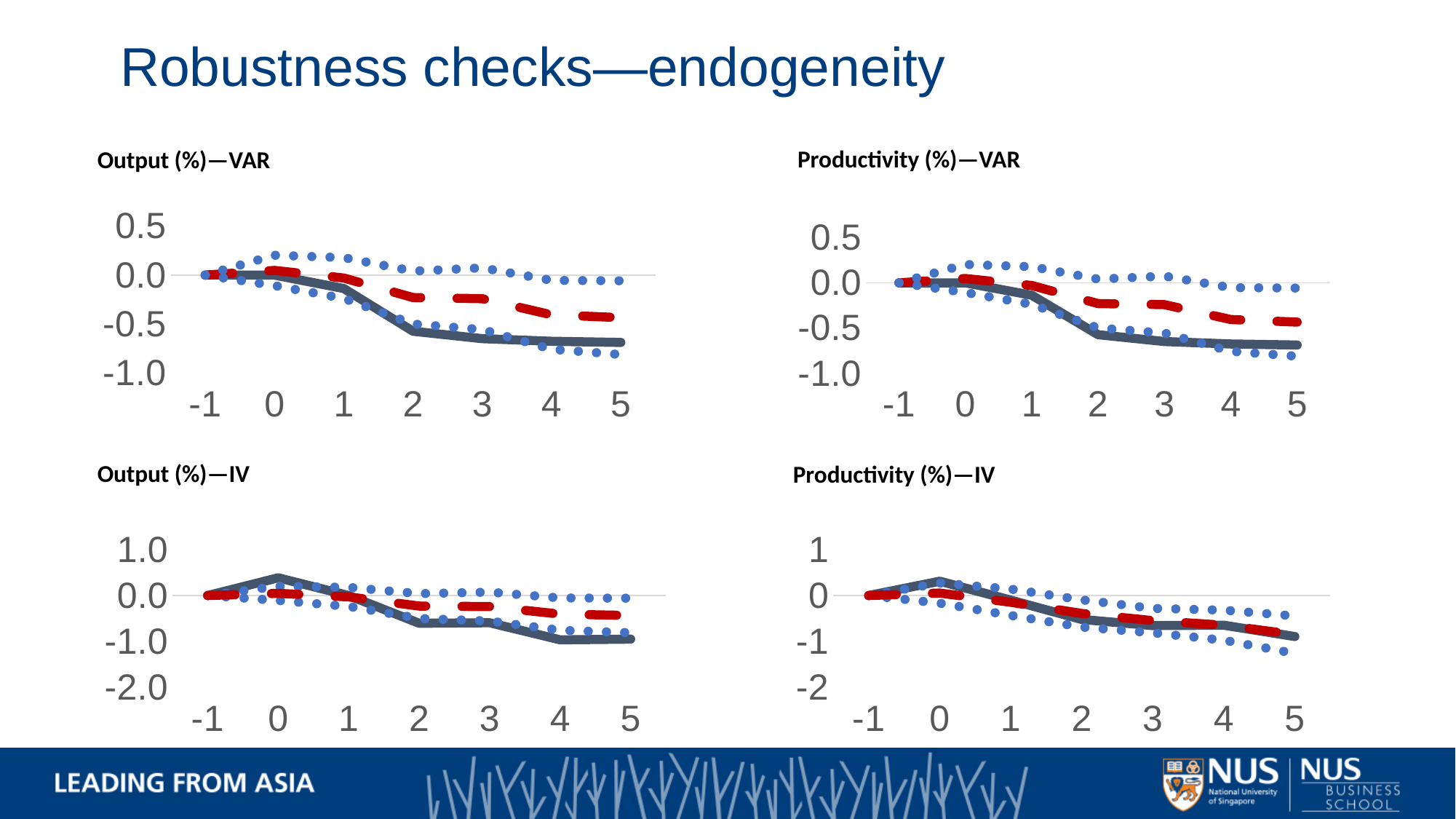
In the "Output (%)—IV" chart, is the solid line higher at x = 0 or at x = 5? x = 0 In the "Output (%)—VAR" chart, is the value of the solid line at x = 5 greater or less than -0.5? less In the "Productivity (%)—VAR" chart, does the solid line rise or fall from x = 1 to x = 3? fall In the "Output (%)—VAR" chart, is the value of the red dashed line at x = 5 greater or less than -0.5? greater What kind of chart is the "Output (%)—VAR" chart? line chart In the "Output (%)—VAR" chart, does the solid line rise or fall from x = 0 to x = 5? fall How many charts are shown on the slide? 4 In the "Output (%)—VAR" chart, how many points are labelled on the x axis? 7 In the "Productivity (%)—VAR" chart, is the value of the solid line at x = 5 greater or less than -0.5? less What is the title of the chart in the bottom-right position of the slide? Productivity (%)—IV